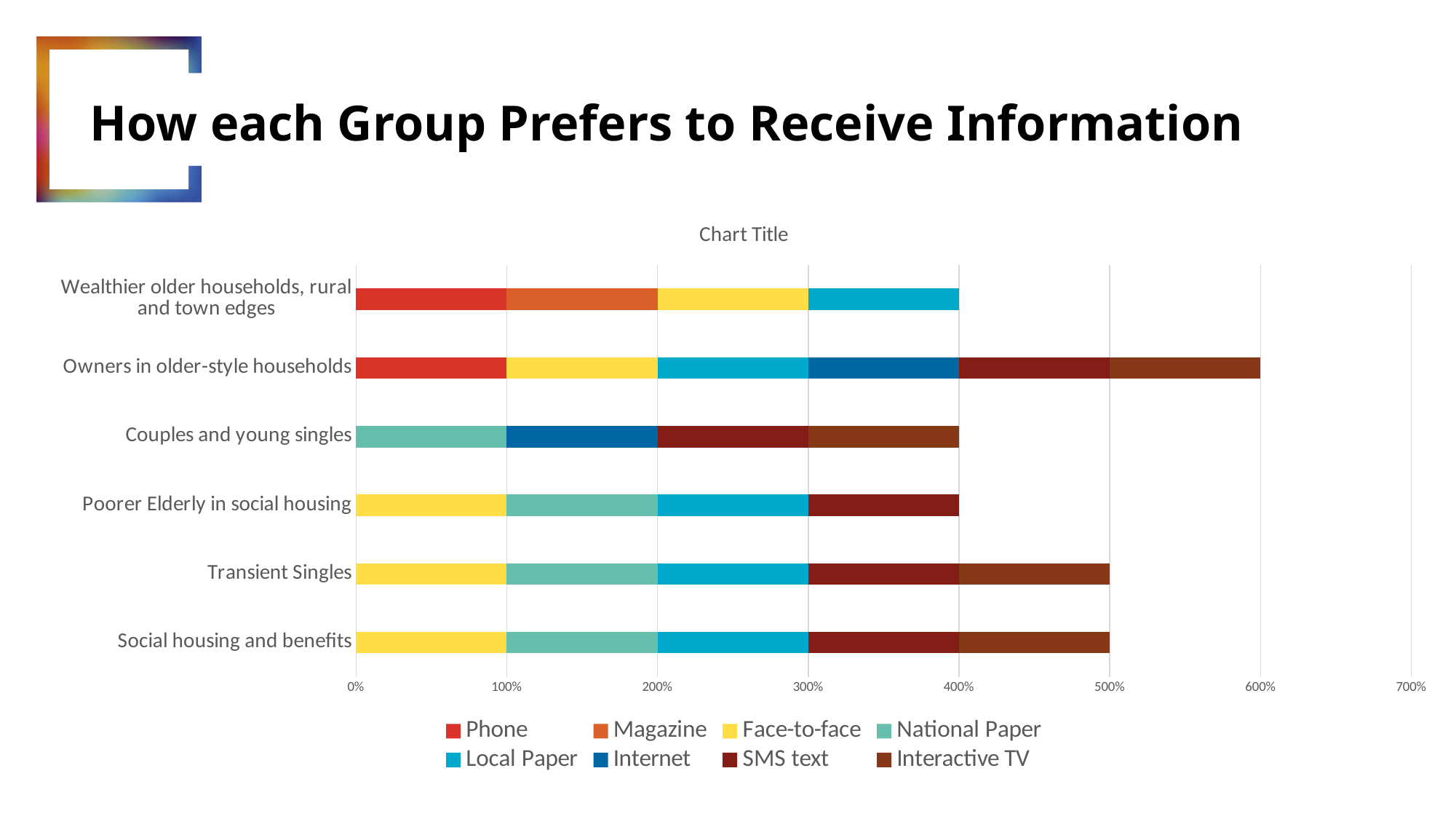
Is the total stacked bar for Social housing and benefits greater or less than 400%? greater What kind of chart is shown on the slide? Stacked bar chart How many series does the legend list? 8 Which group has the longest stacked bar? Owners in older-style households What is the difference between the total stacked bar for Owners in older-style households and the total for Poorer Elderly in social housing? 200% Which series is shown in yellow in the legend? Face-to-face What is the total stacked value for Transient Singles? 500% Which has a longer stacked bar: Transient Singles or Wealthier older households, rural and town edges? Transient Singles What is the total stacked value for Owners in older-style households? 600% What is the total stacked value for Couples and young singles? 400% Is the total stacked bar for Poorer Elderly in social housing greater or less than 500%? less How many groups (categories) are plotted on the chart? 6